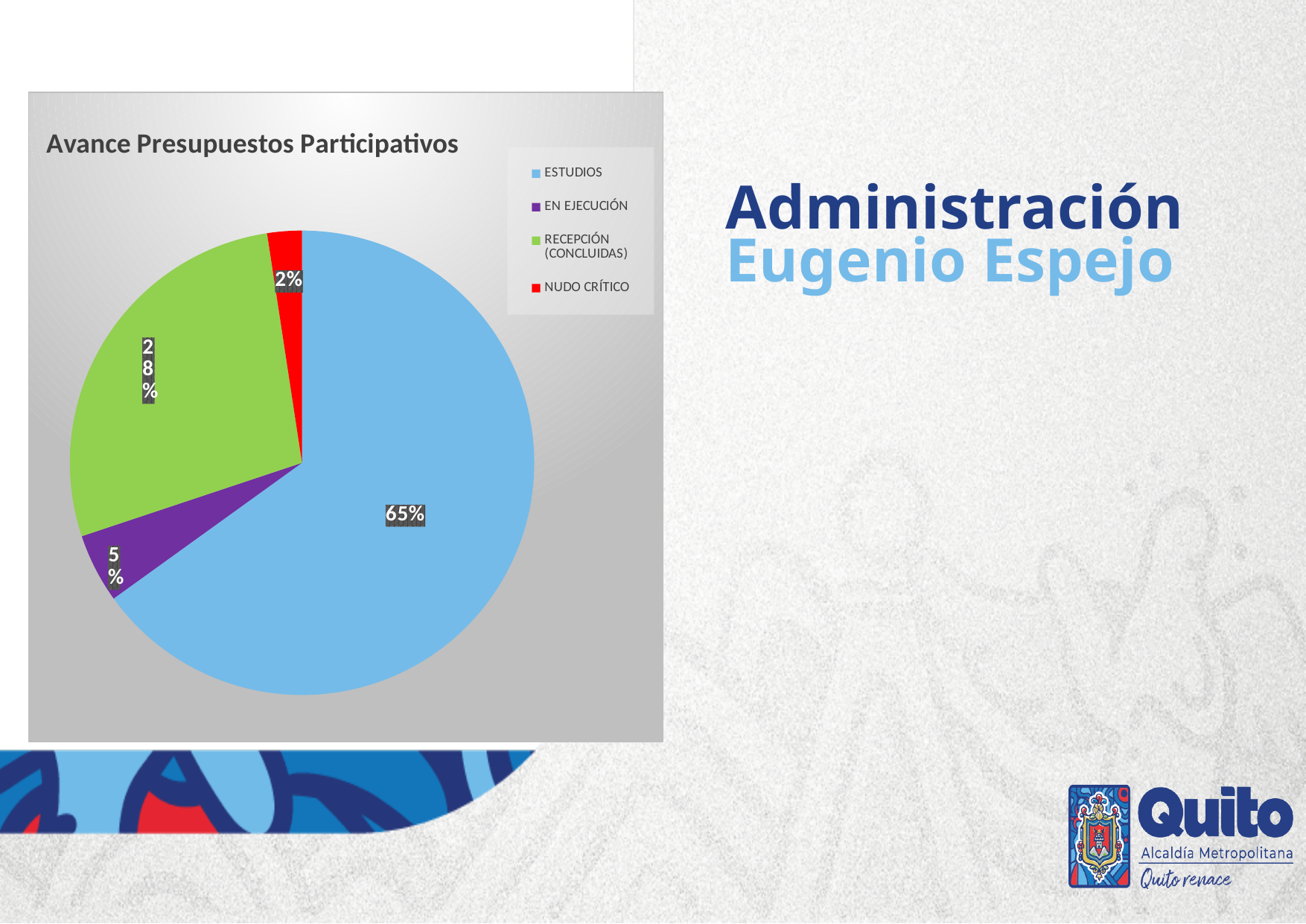
What is the difference in percentage points between ESTUDIOS and RECEPCIÓN (CONCLUIDAS)? 37 What is the title of the chart? Avance Presupuestos Participativos What type of chart is shown on the slide? Pie chart What percentage of the pie does ESTUDIOS represent? 65% What colour represents RECEPCIÓN (CONCLUIDAS) in the chart? Green What percentage of the pie does NUDO CRÍTICO represent? 2% Which is larger, the share for EN EJECUCIÓN or the share for NUDO CRÍTICO? EN EJECUCIÓN What percentage of the pie does EN EJECUCIÓN represent? 5% How many categories does the legend list? 4 Which category has the largest share of the pie? ESTUDIOS What percentage of the pie does RECEPCIÓN (CONCLUIDAS) represent? 28% Which category has the smallest share of the pie? NUDO CRÍTICO